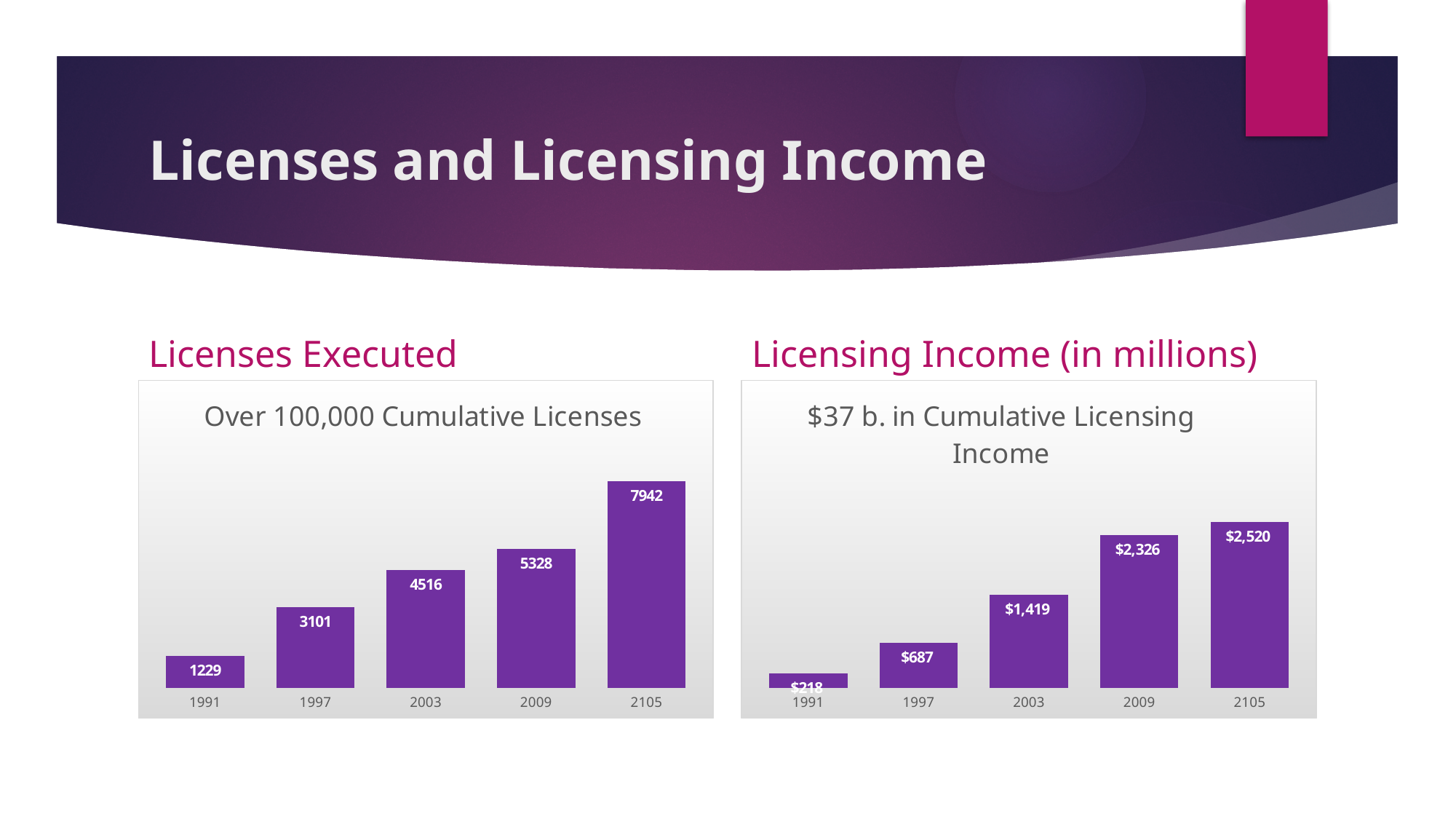
In the '$37 b. in Cumulative Licensing Income' chart, what is the value for 2009? $2,326 In the 'Over 100,000 Cumulative Licenses' chart, which year has the highest value? 2105 In the '$37 b. in Cumulative Licensing Income' chart, which is larger, the value for 2003 or the value for 1997? 2003 In the '$37 b. in Cumulative Licensing Income' chart, which year has the lowest value? 1991 What type of chart is the 'Over 100,000 Cumulative Licenses' chart? bar chart In the '$37 b. in Cumulative Licensing Income' chart, what is the value for 1997? $687 In the 'Over 100,000 Cumulative Licenses' chart, what is the difference between the values for 2009 and 1997? 2227 In the 'Over 100,000 Cumulative Licenses' chart, what is the value for 2003? 4516 In the '$37 b. in Cumulative Licensing Income' chart, what is the difference between the values for 2105 and 2003? $1,101 In the 'Over 100,000 Cumulative Licenses' chart, what is the value for 1991? 1229 In the 'Over 100,000 Cumulative Licenses' chart, how many bars are plotted? 5 In the 'Over 100,000 Cumulative Licenses' chart, do the values rise or fall from left to right? rise